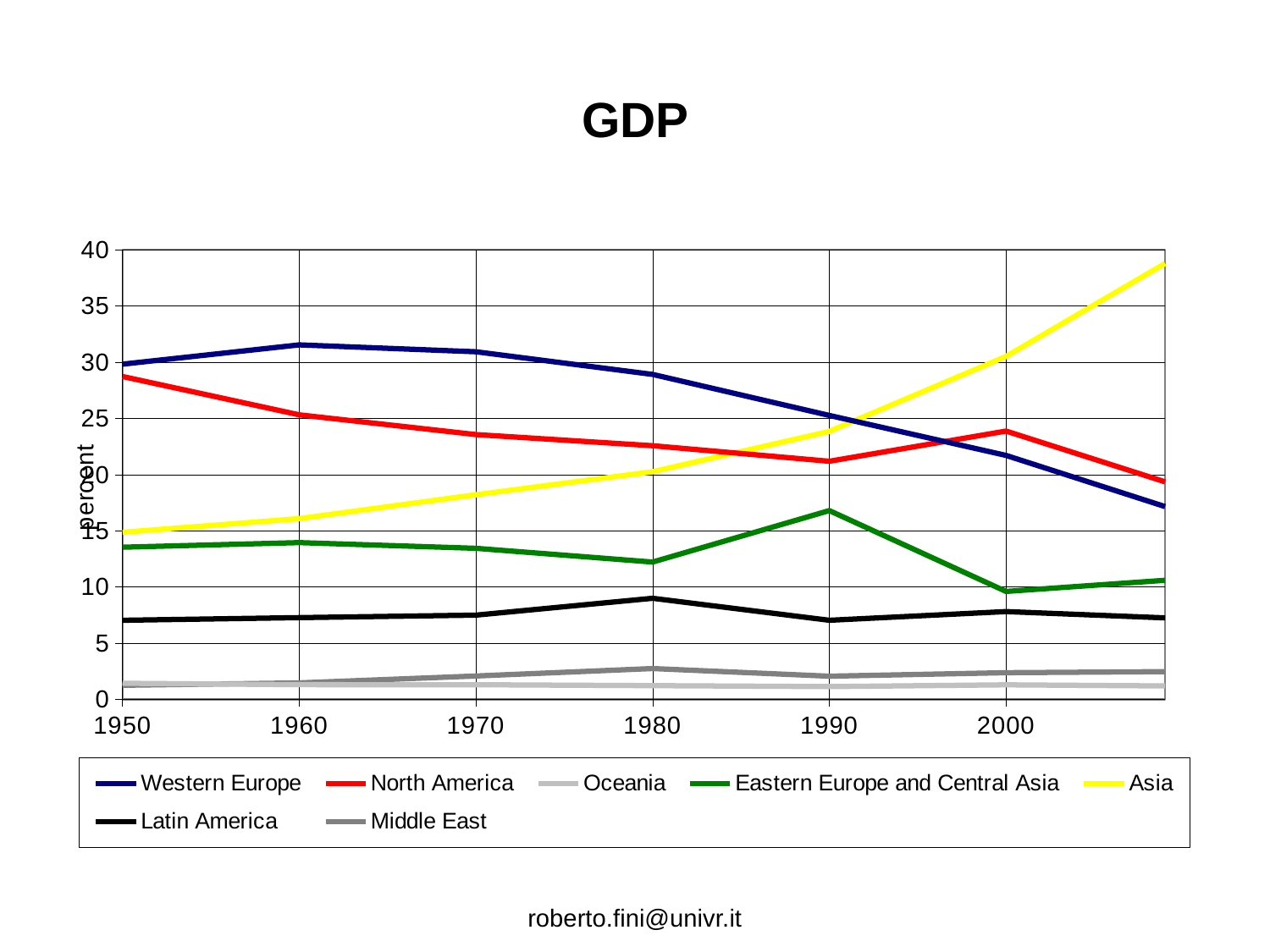
What is the label on the vertical axis? percent What is the title of the chart? GDP Does the Asia series rise or fall from 1950 to the end of the chart? rise Is the value for Asia in 1950 greater or less than 20? less How many series does the legend list? 7 What kind of chart is shown on the slide? line chart Which series has the lowest value in 1990? Oceania Is the value for Latin America in 1980 greater or less than 10? less In 2000, which is larger: North America or Western Europe? North America Is the value for Western Europe in 1960 greater or less than 30? greater Which series has the highest value in 2000? Asia Does the Western Europe series rise or fall from 1960 to the end of the chart? fall